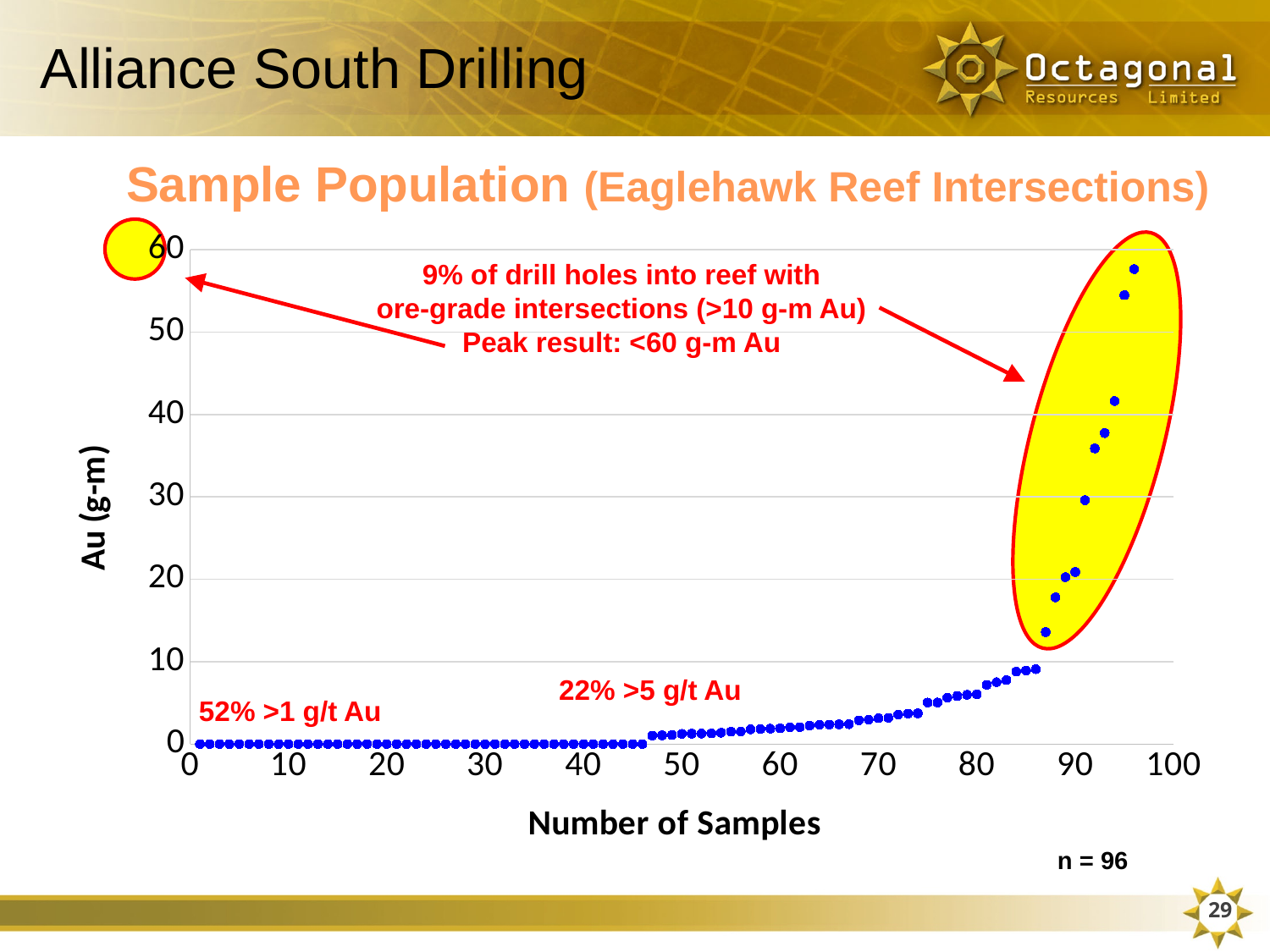
Is the Au (g-m) value for the sample at x = 80 greater or less than 10? less What kind of chart is shown on the slide? Scatter chart Do the plotted Au (g-m) values rise or fall as the number of samples increases along the x axis? Rise What is the label of the y axis? Au (g-m) Is the Au (g-m) value for the sample at x = 40 greater or less than 10? less What is the title of the chart? Sample Population (Eaglehawk Reef Intersections) According to the annotation, what percentage of drill holes into reef have ore-grade intersections (>10 g-m Au)? 9% According to the annotation, what percentage of samples are >1 g/t Au? 52% According to the annotation, what percentage of samples are >5 g/t Au? 22% How many samples are plotted in the chart, according to the n value shown? 96 Is the highest plotted Au (g-m) value greater or less than 50? greater